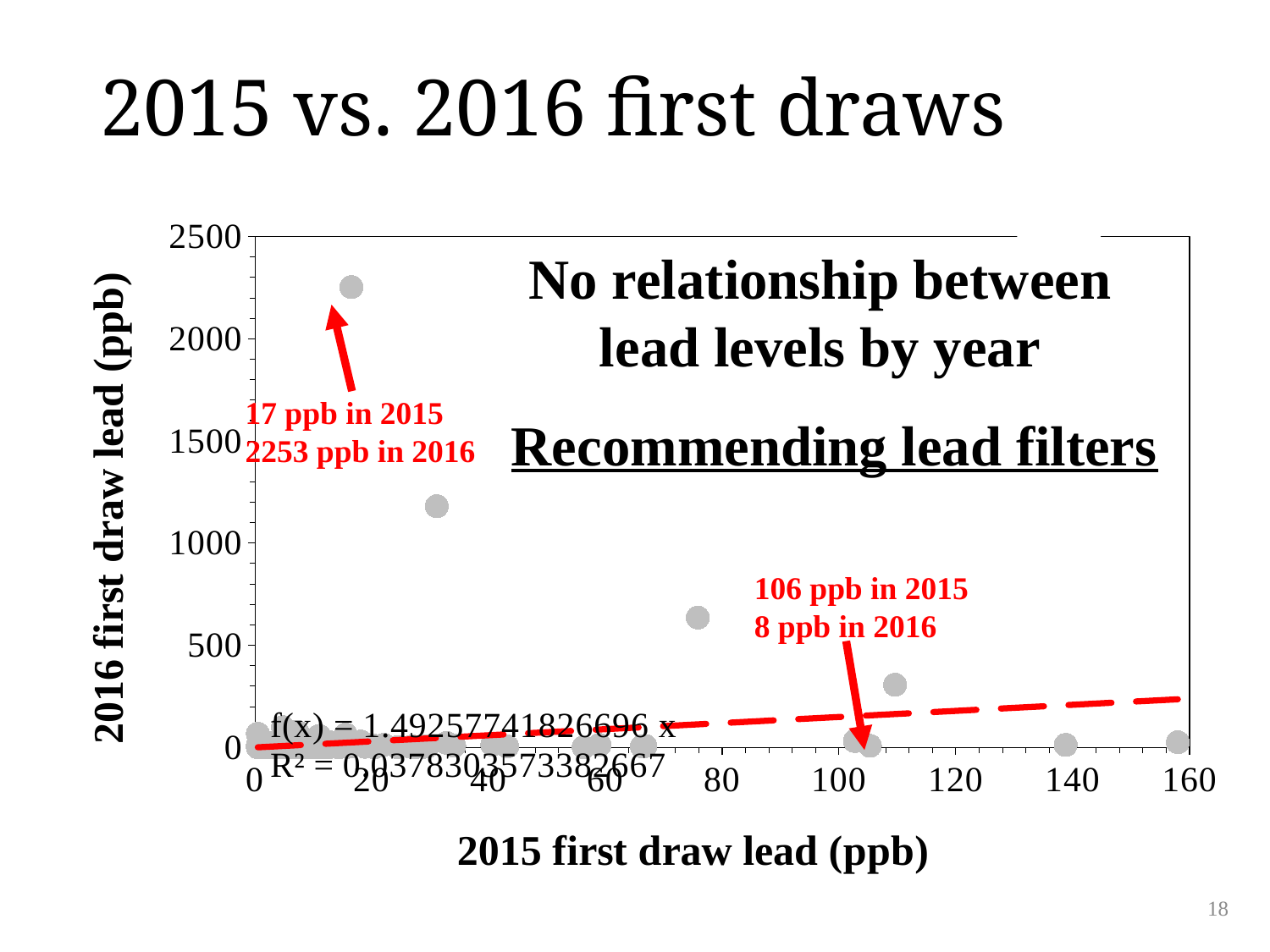
What R² value is printed for the trendline? 0.0378303573382667 What is the label of the y axis? 2016 first draw lead (ppb) What is the label of the x axis? 2015 first draw lead (ppb) According to the annotation, what was the 2016 first draw lead level for the sample that had 17 ppb in 2015? 2253 ppb According to the annotation, what was the 2016 first draw lead level for the sample that had 106 ppb in 2015? 8 ppb Is the 2016 first draw lead value for the point at roughly 75 ppb in 2015 greater or less than 1000? less What is the difference between the 2016 lead levels of the two annotated samples (2253 ppb and 8 ppb)? 2245 ppb Which annotated sample has the higher 2016 first draw lead level: the one with 17 ppb in 2015 or the one with 106 ppb in 2015? the one with 17 ppb in 2015 What was the 2015 first draw lead level for the sample annotated as 2253 ppb in 2016? 17 ppb Is the 2016 first draw lead value for the point at roughly 30 ppb in 2015 greater or less than 1000? greater What is the equation of the trendline printed on the chart? f(x) = 1.49257741826696 x What kind of chart is shown on the slide? scatter plot